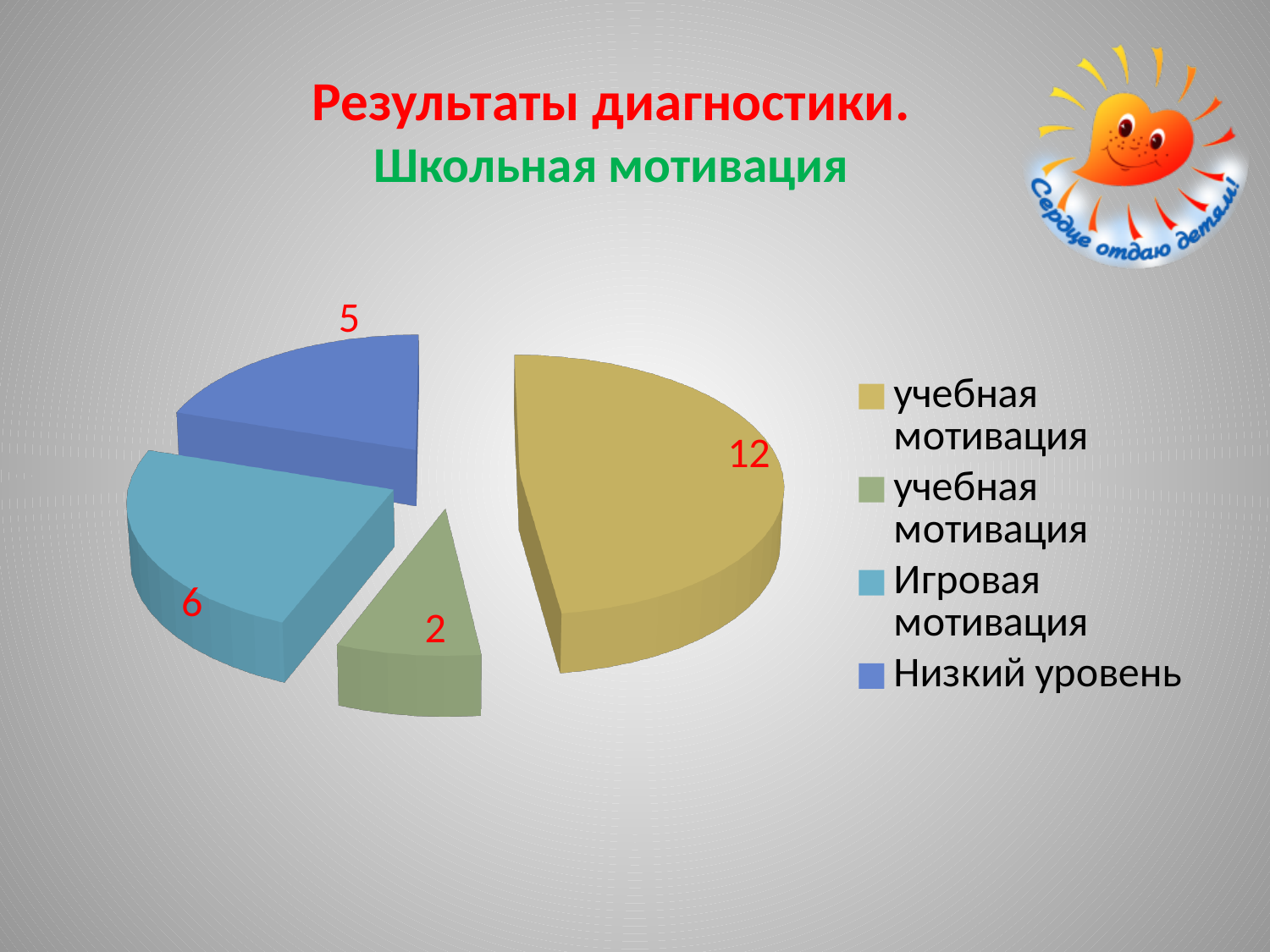
How many slices does the pie chart have? 4 What is the value of the Игровая мотивация slice? 6 Which is larger, Игровая мотивация or Низкий уровень? Игровая мотивация What is the value of the gold (yellow) slice? 12 Which slice has the smallest value? the green учебная мотивация slice (2) What is the difference between the Игровая мотивация value and the Низкий уровень value? 1 What share of the pie does the Игровая мотивация slice represent? 24% What kind of chart is shown on the slide? pie chart What is the value of the green slice? 2 How many entries does the legend list? 4 What is the value of the Низкий уровень slice? 5 Which slice has the largest value? the gold учебная мотивация slice (12)